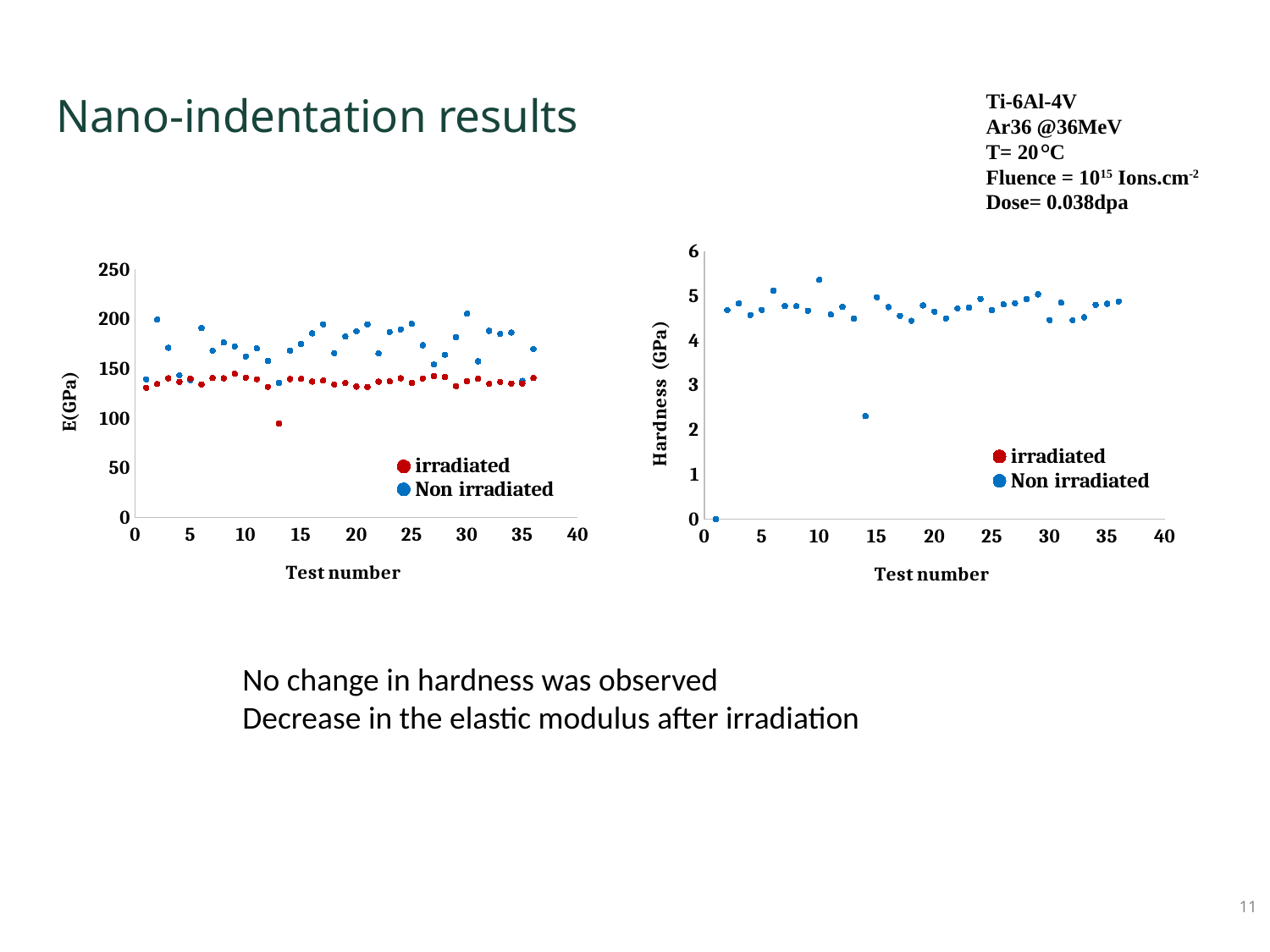
In the left chart, is the irradiated value at test number 13 greater or less than 100? less In the left chart, at test number 30, which series has the higher value, irradiated or Non irradiated? Non irradiated In the left chart, is the Non irradiated value at test number 2 greater or less than 150? greater What is the y-axis label of the right chart? Hardness (GPa) How many series does the legend of the right chart list? 2 In the right chart, is the value at test number 14 greater or less than 3? less How many series does the legend of the left chart list? 2 In the right chart, at which test number is the lowest plotted value? 1 In the left chart, are the irradiated values generally higher or lower than the Non irradiated values? lower What is the y-axis label of the left chart? E(GPa) What kind of chart is the left chart (E(GPa) vs Test number)? scatter chart